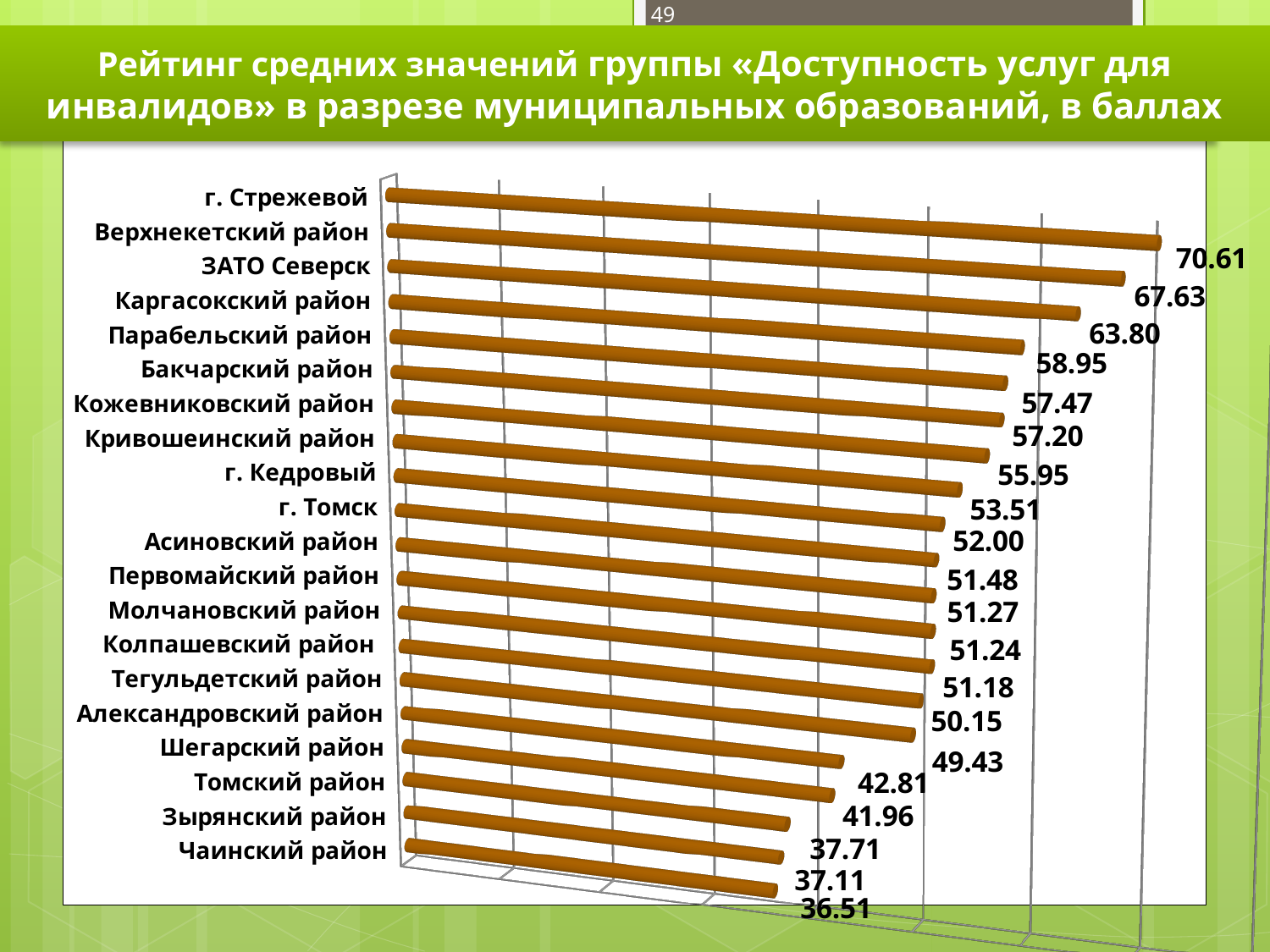
Which municipality has the lowest value? Чаинский район What is the value for ЗАТО Северск? 63.80 How many municipalities are shown in the chart? 20 Which municipality has the highest value? г. Стрежевой What is the difference between the values for Каргасокский район and Чаинский район? 22.44 What is the value for г. Стрежевой? 70.61 Do the values increase or decrease going down the list of municipalities from top to bottom? Decrease What is the difference between the values for г. Стрежевой and Верхнекетский район? 2.98 What kind of chart is shown on the slide? Bar chart What is the value for г. Томск? 51.48 What is the value for Чаинский район? 36.51 Which has a larger value, Александровский район or Шегарский район? Александровский район